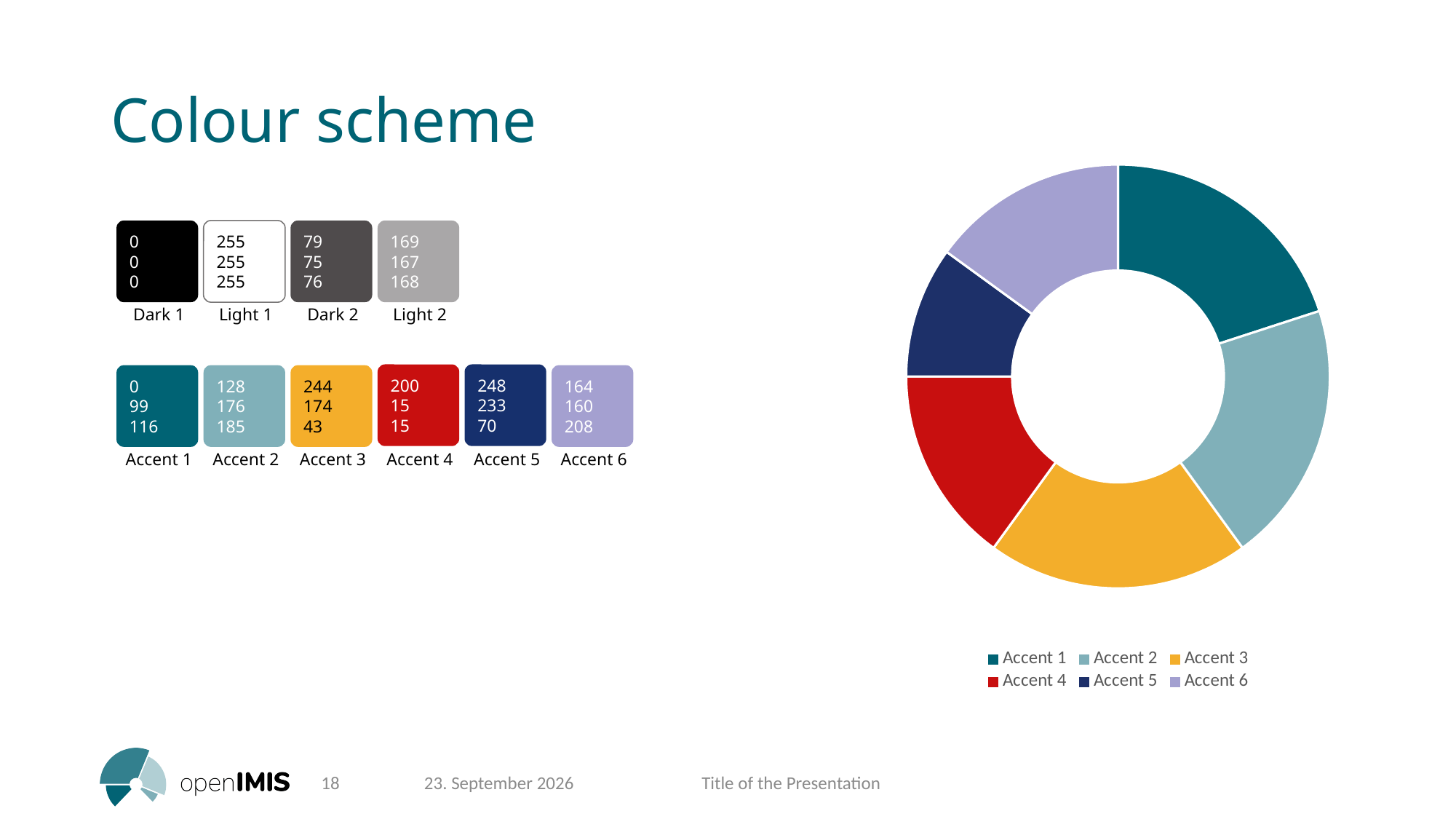
Which legend entry is shown in yellow-orange in the doughnut chart? Accent 3 Which slice is larger in the doughnut chart, Accent 1 or Accent 5? Accent 1 Which slice is larger in the doughnut chart, Accent 2 or Accent 4? Accent 2 Which slice is larger in the doughnut chart, Accent 4 or Accent 5? Accent 4 What colour is the Accent 4 slice in the doughnut chart? red How many entries does the chart legend list? 6 Which slice of the doughnut chart is the smallest? Accent 5 How many slices does the doughnut chart have? 6 What kind of chart is shown on the slide? doughnut chart